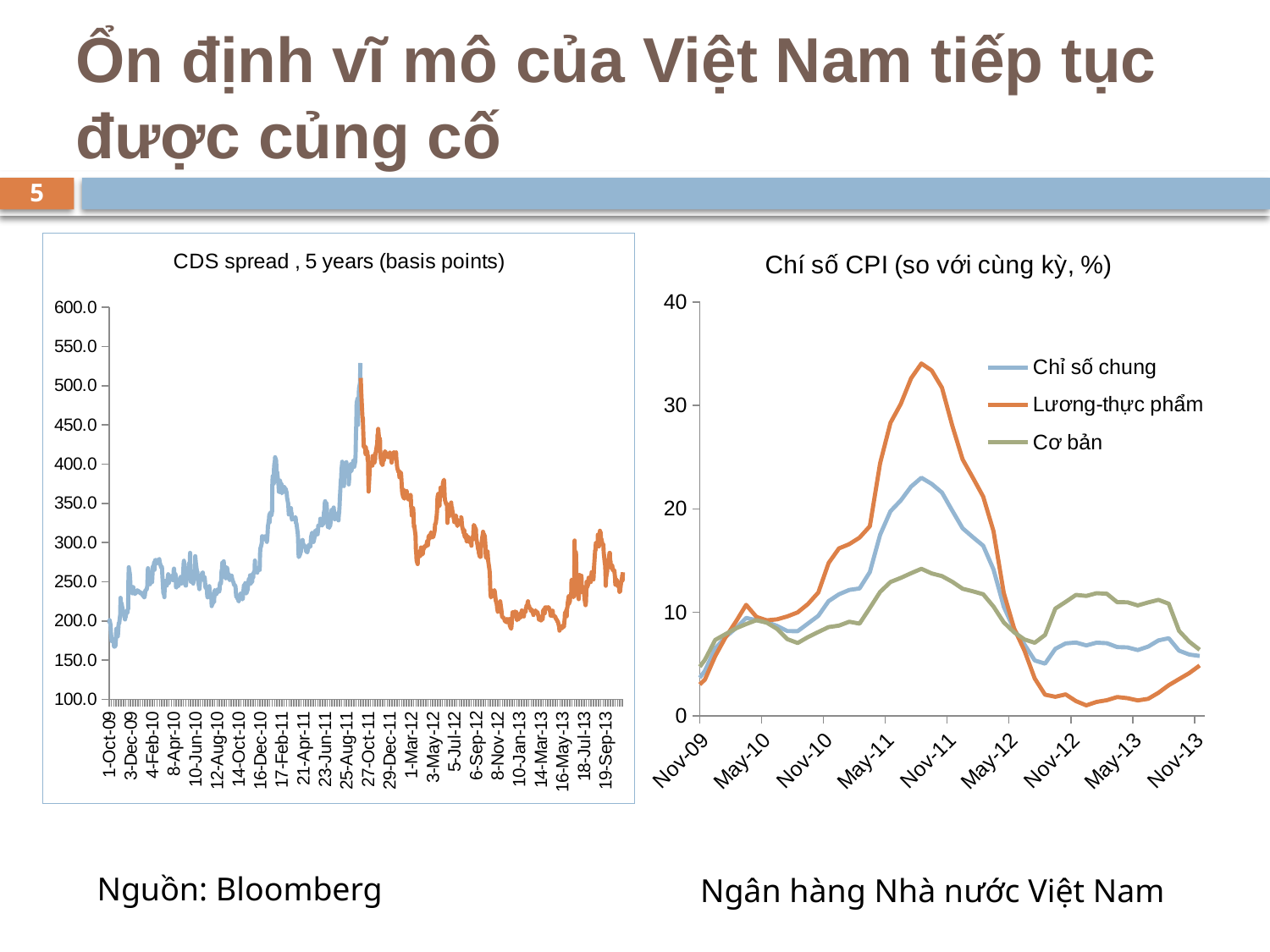
In the 'Chí số CPI (so với cùng kỳ, %)' chart, is the value of Chỉ số chung at Nov-13 greater or less than 10? less In the 'Chí số CPI (so với cùng kỳ, %)' chart, which series is highest around Nov-11? Lương-thực phẩm In the 'Chí số CPI (so với cùng kỳ, %)' chart, is the peak value of Cơ bản greater or less than 20? less In the 'Chí số CPI (so với cùng kỳ, %)' chart, is the peak value of Lương-thực phẩm greater or less than 30? greater In the 'Chí số CPI (so với cùng kỳ, %)' chart, how many series does the legend list? 3 In the 'Chí số CPI (so với cùng kỳ, %)' chart, which series is lowest at May-13? Lương-thực phẩm What kind of chart is the 'Chí số CPI (so với cùng kỳ, %)' chart on the right? line chart What kind of chart is the 'CDS spread , 5 years (basis points)' chart on the left? line chart In the 'Chí số CPI (so với cùng kỳ, %)' chart, does the Lương-thực phẩm line rise or fall between Nov-11 and Nov-12? fall In the 'Chí số CPI (so với cùng kỳ, %)' chart, what are the three legend entries? Chỉ số chung, Lương-thực phẩm, Cơ bản